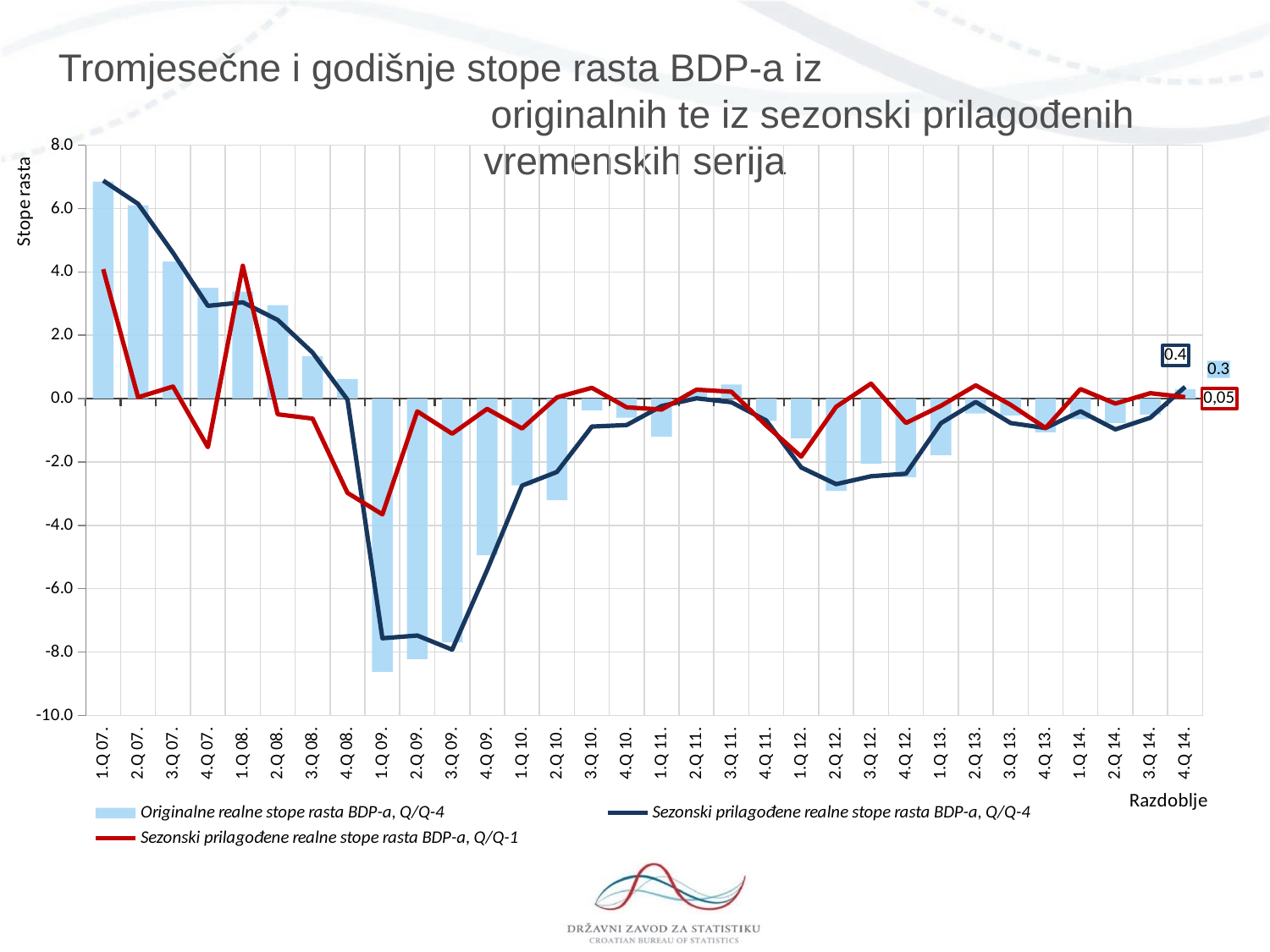
What is the data label shown for the original real GDP growth rate (Q/Q-4) bar at 4.Q 14.? 0.3 How many quarters are shown on the x axis? 32 Which quarter has the lowest bar for the original real GDP growth rate (Q/Q-4)? 1.Q 09. What is the data label shown for the seasonally adjusted Q/Q-1 series at 4.Q 14.? 0,05 Is the original real GDP growth rate bar for 4.Q 09. greater or less than -4.0? less What is the data label shown for the seasonally adjusted Q/Q-4 series at 4.Q 14.? 0.4 Is the original real GDP growth rate bar for 1.Q 09. greater or less than -8.0? less Which quarter has the highest bar for the original real GDP growth rate (Q/Q-4)? 1.Q 07. What kind of chart is shown on the slide? Combined bar and line chart Is the original real GDP growth rate bar for 1.Q 07. greater or less than 6.0? greater Do the original real GDP growth rate bars rise or fall from 1.Q 07. to 1.Q 09.? fall How many series does the legend list? 3